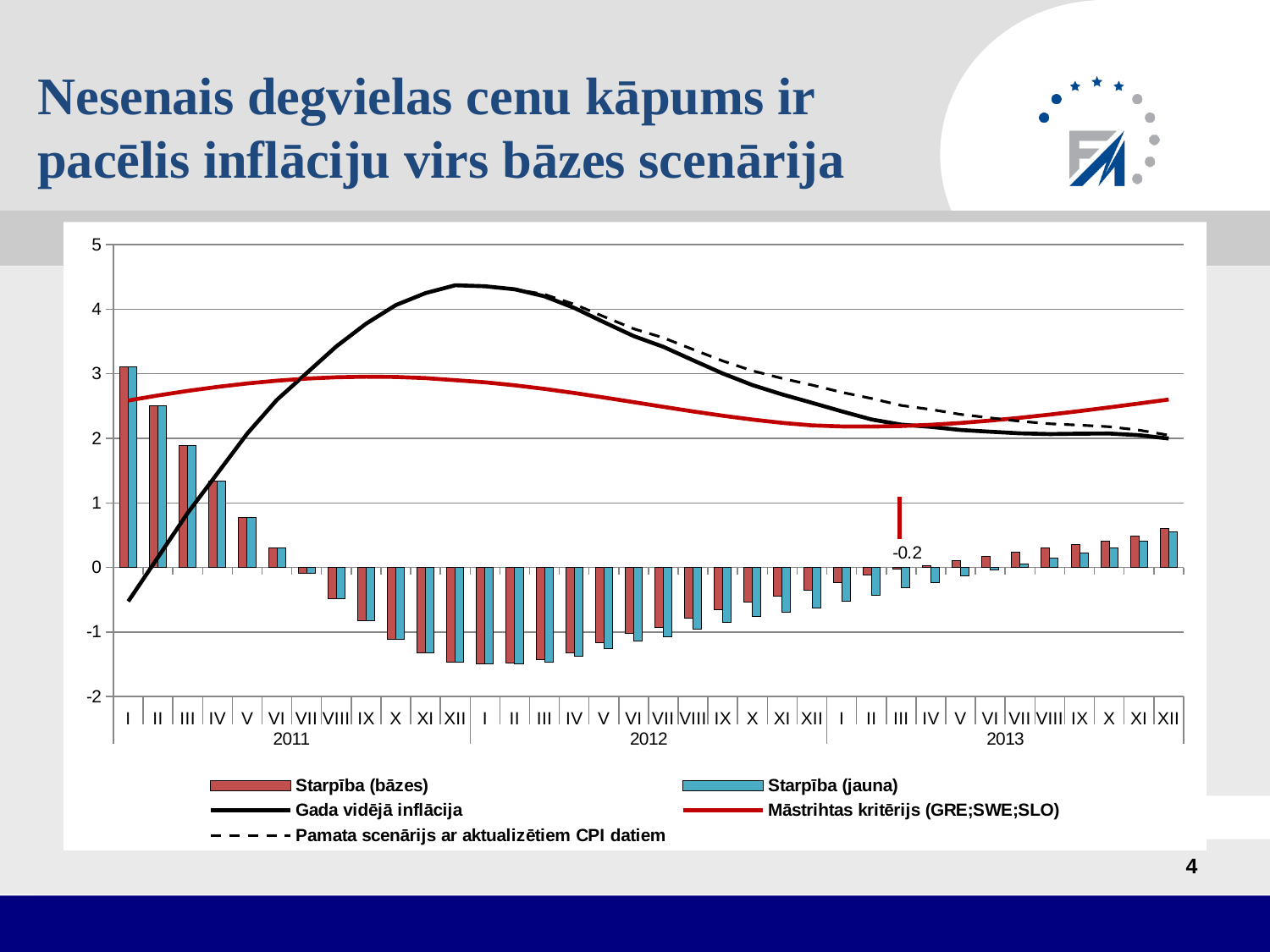
How many years are shown along the x axis? 3 How many series does the legend list? 5 In I 2012, which is larger: Gada vidējā inflācija or Māstrihtas kritērijs (GRE;SWE;SLO)? Gada vidējā inflācija Is the value of Gada vidējā inflācija in I 2011 greater or less than 0? less Is the peak value of Gada vidējā inflācija greater or less than 4? greater What value is printed as a data label near the bar for III 2013? -0.2 What kind of chart is shown on the slide? A combined bar and line chart Is the Starpība (bāzes) bar for I 2011 greater or less than 2? greater Do the Starpība bars rise or fall from I 2011 to VI 2011? fall In which month is the Starpība (bāzes) bar the highest? I 2011 Which series is drawn as a dashed line? Pamata scenārijs ar aktualizētiem CPI datiem